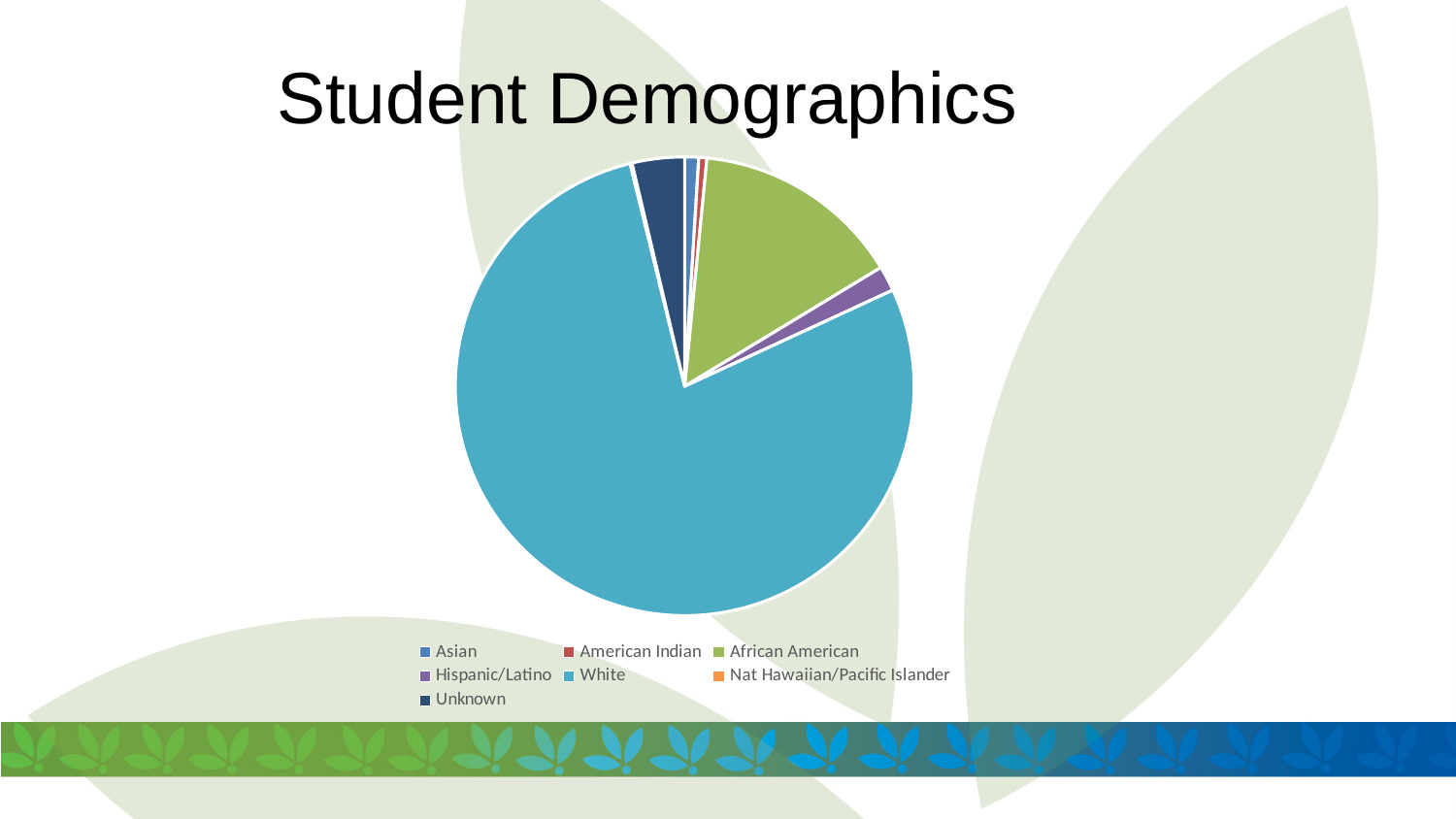
Which slice is larger, Unknown or Asian? Unknown How many categories does the legend of the pie chart list? 7 Which slice is larger, White or African American? White Which slice is larger, African American or Unknown? African American What colour is the White slice in the pie chart? light blue What is the title of the slide containing the pie chart? Student Demographics What kind of chart is shown on the slide? pie chart Which category has the second largest slice of the pie chart? African American Which category has the largest slice of the pie chart? White